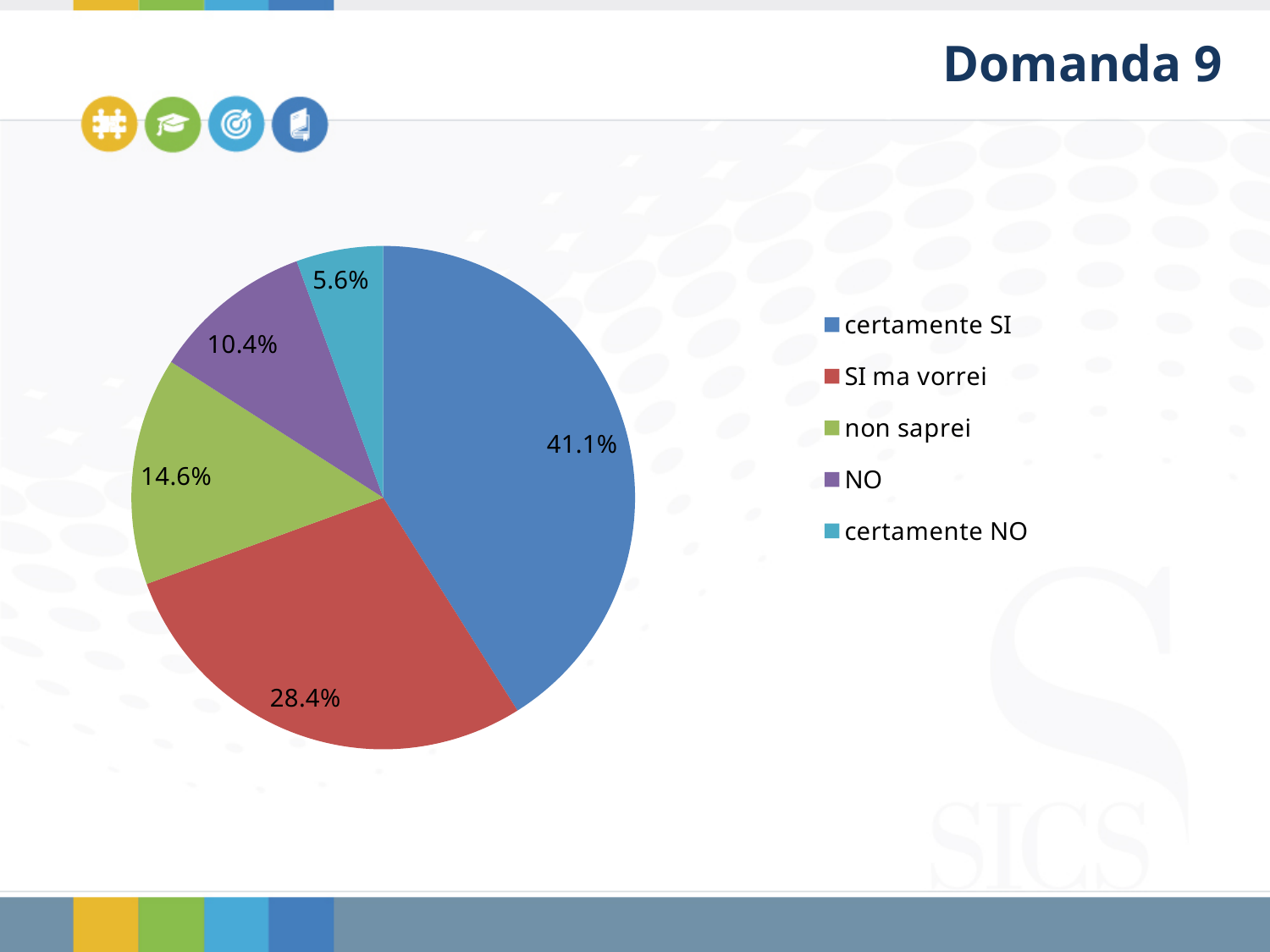
What is the difference in percentage points between 'certamente SI' and 'SI ma vorrei'? 12.7 What percentage of the pie is 'SI ma vorrei'? 28.4% Which is larger, the share for 'non saprei' or the share for 'NO'? non saprei Which category has the largest share of the pie? certamente SI What percentage of the pie is 'certamente NO'? 5.6% How many slices does the pie chart have? 5 What percentage of the pie is 'certamente SI'? 41.1% Which category has the smallest share of the pie? certamente NO What kind of chart is shown on the slide? pie chart What percentage of the pie is 'non saprei'? 14.6% What percentage of the pie is 'NO'? 10.4% What is the title of the slide containing the pie chart? Domanda 9